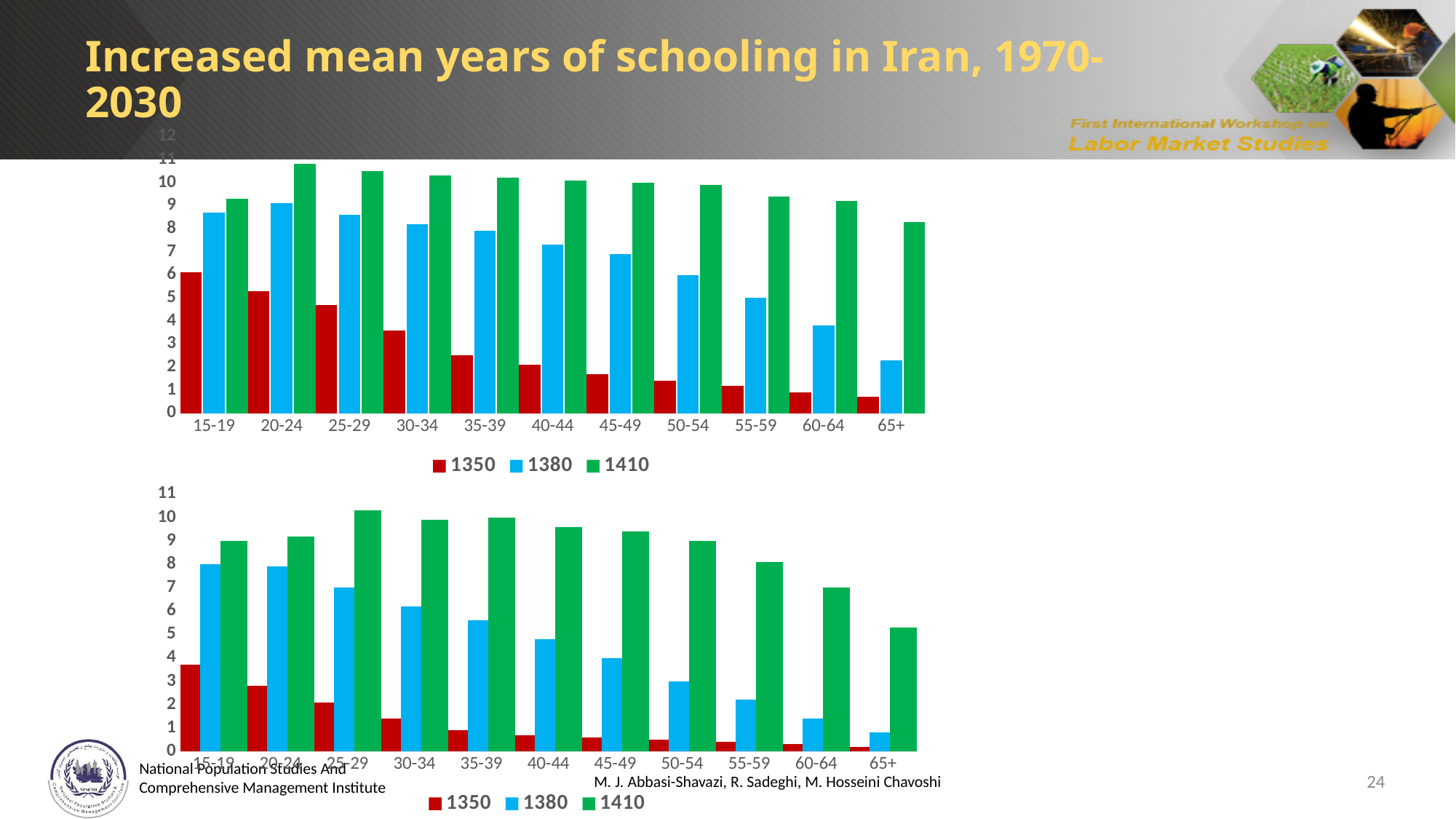
In the top chart, do the values for the 1350 series rise or fall as you move from 15-19 to 65+? fall In the top chart, is the value for the 1410 series at 20-24 greater or less than 10? greater In the bottom chart, which age group has the lowest value for the 1380 series? 65+ How many series does the legend of the top chart list? 3 What kind of chart is the top chart on the slide? bar chart How many age-group categories are shown on the x axis of the bottom chart? 11 What are the three legend entries of the bottom chart? 1350, 1380, 1410 In the top chart, which age group has the highest value for the 1410 series? 20-24 In the top chart, is the value for the 1350 series at 30-34 greater or less than 4? less In the top chart, which age group has the lowest value for the 1350 series? 65+ In the bottom chart, at 65+, which series has the larger value, 1380 or 1410? 1410 In the bottom chart, is the value for the 1350 series at 15-19 greater or less than 3? greater